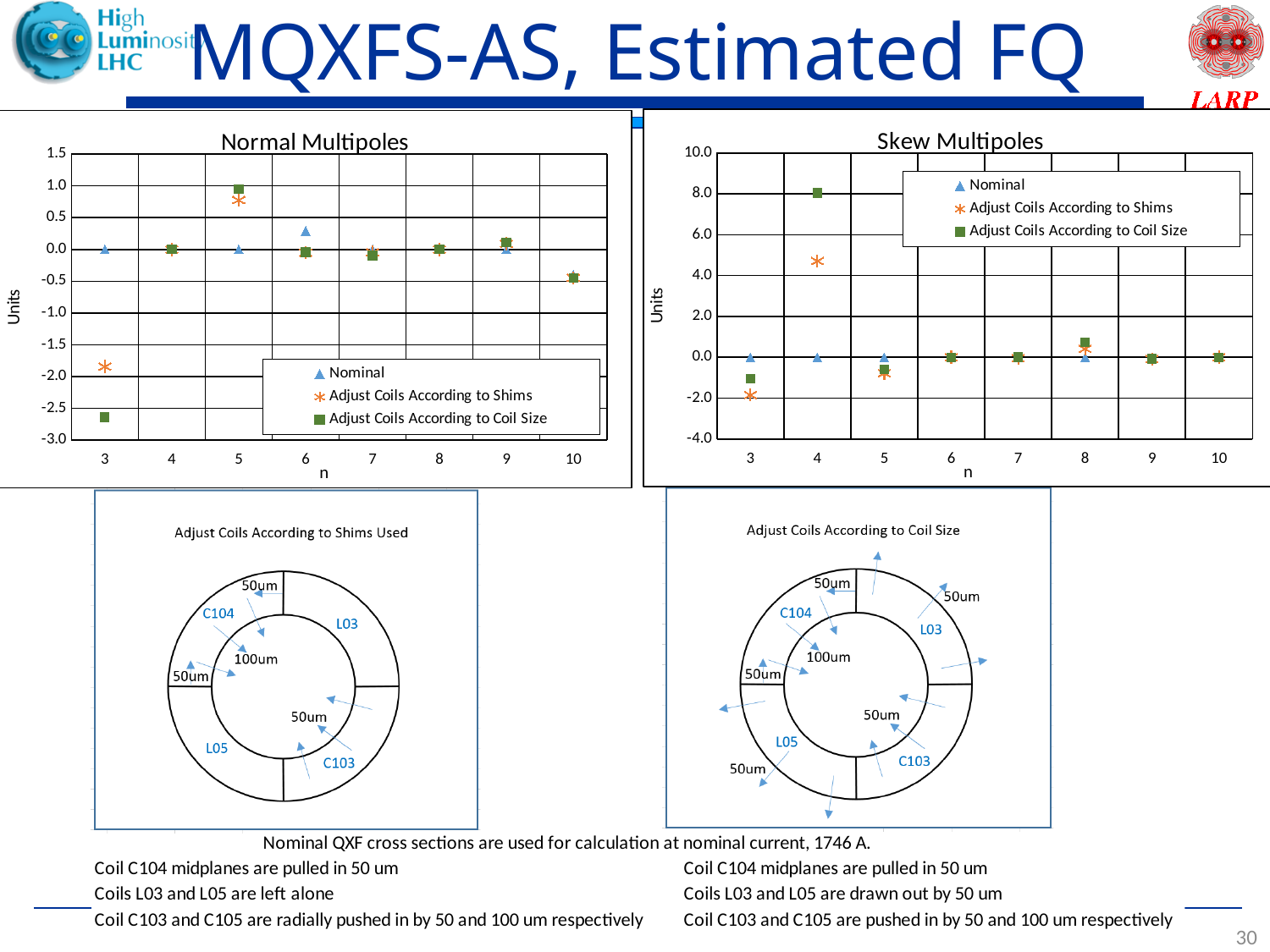
In the Skew Multipoles chart, is the value for Adjust Coils According to Coil Size at n = 4 greater or less than 6.0? greater In the Normal Multipoles chart, is the value for Adjust Coils According to Coil Size at n = 3 greater or less than -2.5? less In the Normal Multipoles chart, at which n does the Adjust Coils According to Coil Size series reach its lowest value? 3 In the Normal Multipoles chart at n = 3, which is larger: the value for Adjust Coils According to Shims or for Adjust Coils According to Coil Size? Adjust Coils According to Shims What kind of chart is the Normal Multipoles chart? scatter chart In the Normal Multipoles chart, is the value for Adjust Coils According to Coil Size at n = 5 greater or less than 0.5? greater What is the label of the y axis on the Skew Multipoles chart? Units How many values of n are plotted along the x axis of the Normal Multipoles chart? 8 In the Skew Multipoles chart, at which n does the Adjust Coils According to Coil Size series reach its highest value? 4 How many series does the legend of the Skew Multipoles chart list? 3